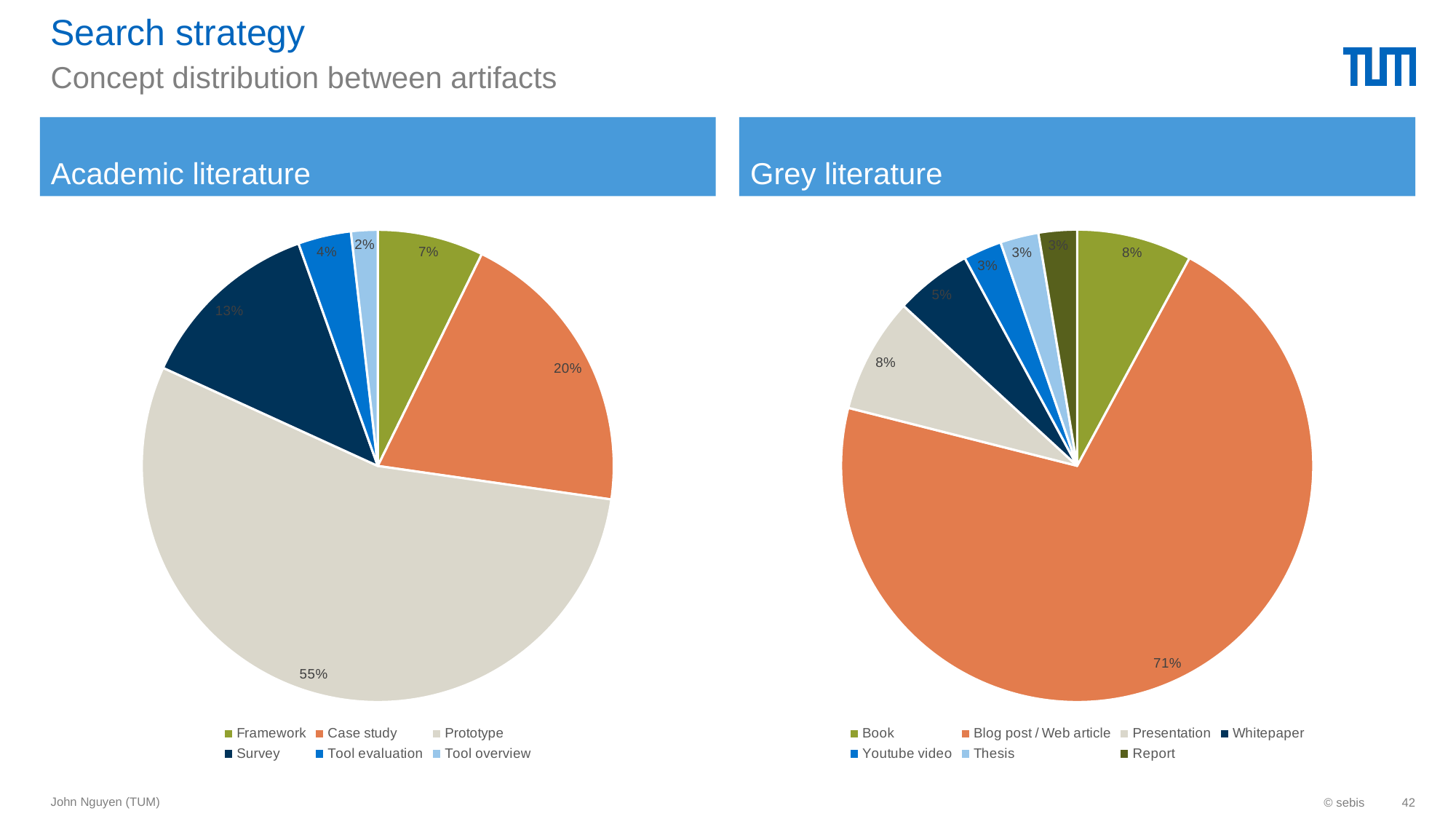
In the Academic literature chart, what share does Case study have? 20% In the Grey literature chart, what share does Blog post / Web article have? 71% What kind of chart is the Grey literature chart? Pie chart In the Grey literature chart, which category has the largest share? Blog post / Web article In the Grey literature chart, what share does Whitepaper have? 5% In the Academic literature chart, which category has the smallest share? Tool overview In the Academic literature chart, what is the difference between the Survey share and the Framework share? 6% How many categories does the Academic literature chart show? 6 How many categories does the Grey literature chart show? 7 In the Academic literature chart, what share does Prototype have? 55% In the Grey literature chart, what is the difference between the Blog post / Web article share and the Book share? 63% In the Academic literature chart, which is larger, Survey or Case study? Case study